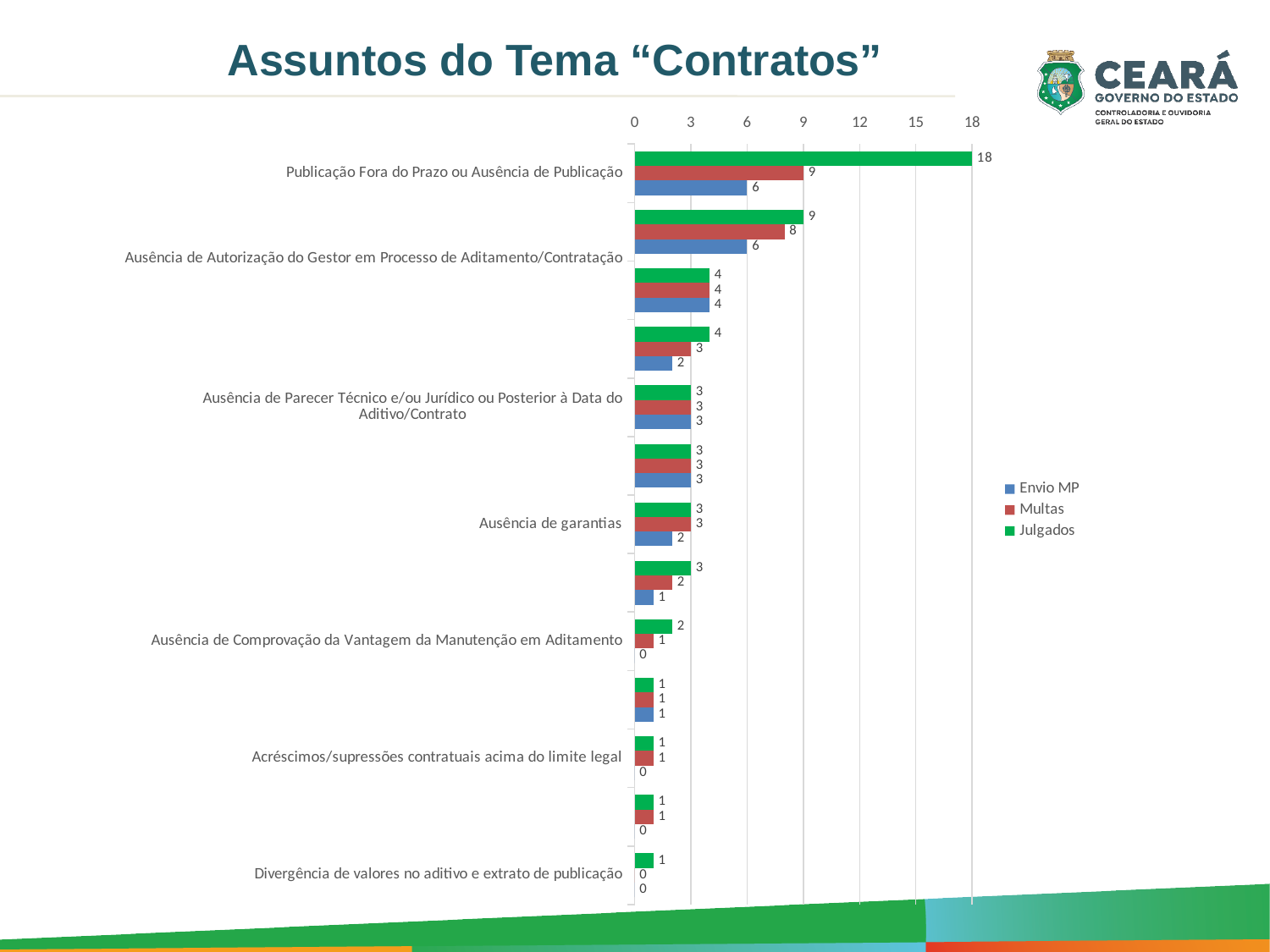
What is the title of the chart? Assuntos do Tema "Contratos" What is the difference between the Julgados and Multas values for "Publicação Fora do Prazo ou Ausência de Publicação"? 9 How many series does the legend list? 3 What is the Envio MP value for "Publicação Fora do Prazo ou Ausência de Publicação"? 6 What is the Multas value for "Publicação Fora do Prazo ou Ausência de Publicação"? 9 What kind of chart is shown on the slide? bar chart What is the Julgados value for "Publicação Fora do Prazo ou Ausência de Publicação"? 18 Which series does the legend list? Envio MP, Multas, Julgados Which category has the highest Julgados value? Publicação Fora do Prazo ou Ausência de Publicação Is the Julgados value for "Publicação Fora do Prazo ou Ausência de Publicação" greater or less than 15? greater What is the Envio MP value for "Ausência de garantias"? 2 What is the Envio MP value for "Ausência de Comprovação da Vantagem da Manutenção em Aditamento"? 0